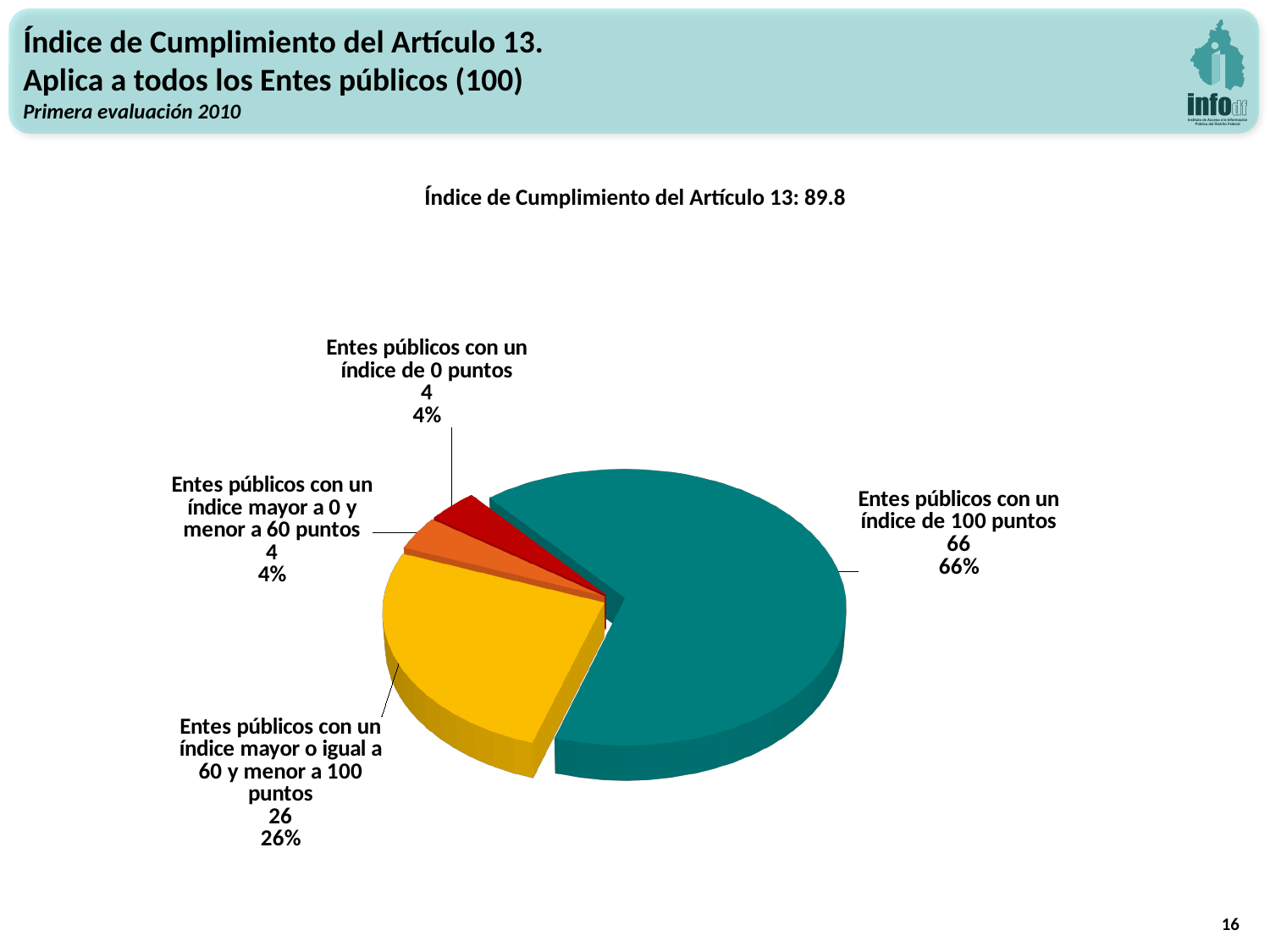
What kind of chart is shown on the slide? pie chart How many slices does the pie chart have? 4 What colour is the slice for public entities with an index of 100 points? teal What is the Índice de Cumplimiento del Artículo 13 value stated in the chart title? 89.8 Which is larger: the number of public entities with an index of 100 points or those with an index greater than or equal to 60 and less than 100 points? Entes públicos con un índice de 100 puntos What percentage of the pie corresponds to public entities with an index of 100 points? 66% How many public entities have an index greater than or equal to 60 and less than 100 points? 26 What is the difference between the number of public entities with an index of 100 points and those with an index greater than or equal to 60 and less than 100 points? 40 Which category has the largest slice of the pie? Entes públicos con un índice de 100 puntos How many public entities have an index of 100 points? 66 What is the total number of public entities across all four slices? 100 What share of the pie is for public entities with an index of 0 points? 4%